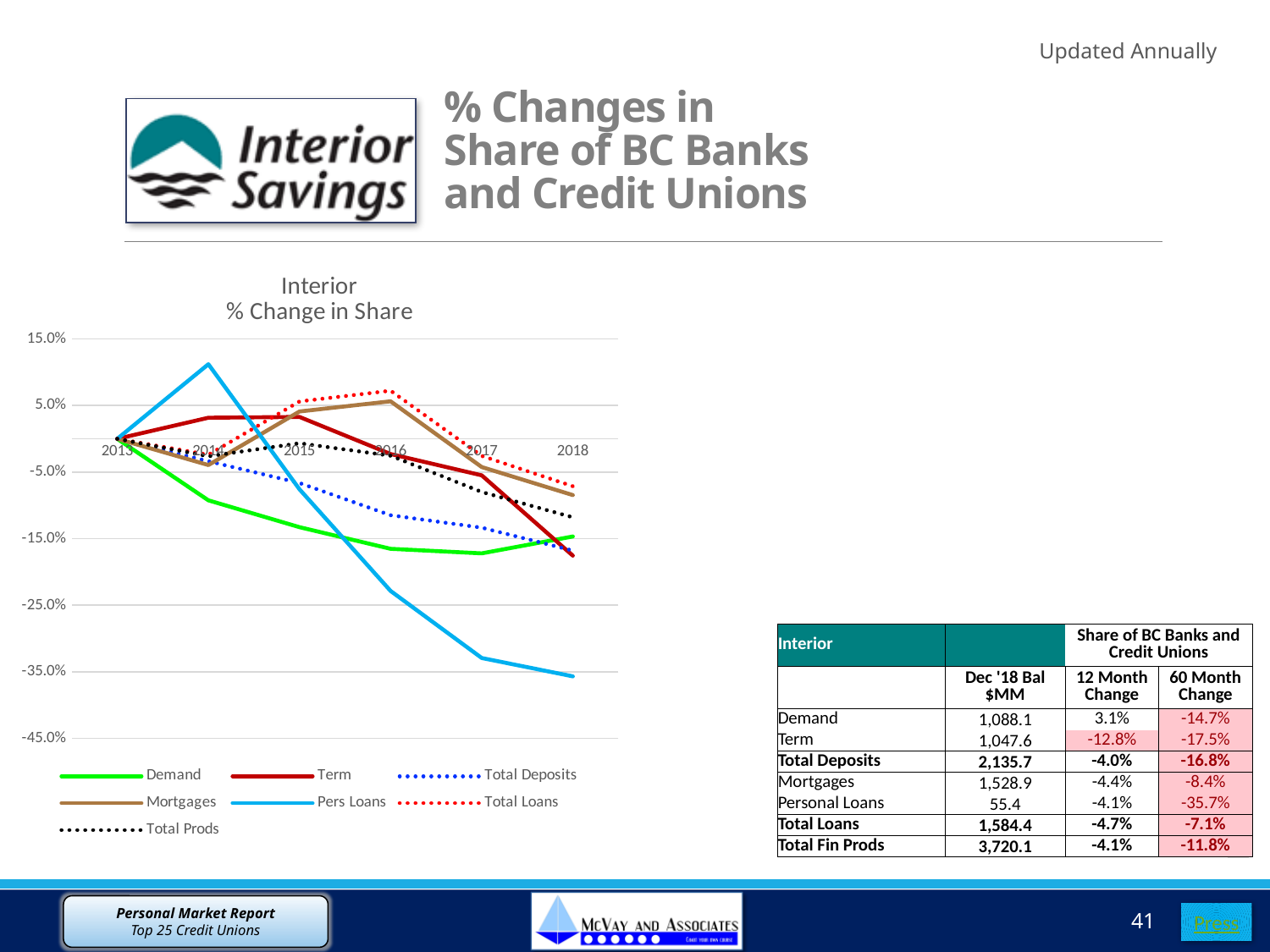
Is the value for Mortgages in 2018 greater or less than -5.0%? less Does the Pers Loans line rise or fall from 2014 to 2018? fall In 2018, which is larger: the value for Demand or the value for Pers Loans? Demand What kind of chart is shown on the slide? line chart How many years are plotted along the x axis of the chart? 6 Is the value for Pers Loans in 2014 greater or less than 5.0%? greater Which series has the highest value in 2014? Pers Loans Is the value for Demand in 2016 greater or less than -15.0%? less What is the title of the chart? Interior % Change in Share How many series does the chart legend list? 7 Which series has the lowest value in 2018? Pers Loans